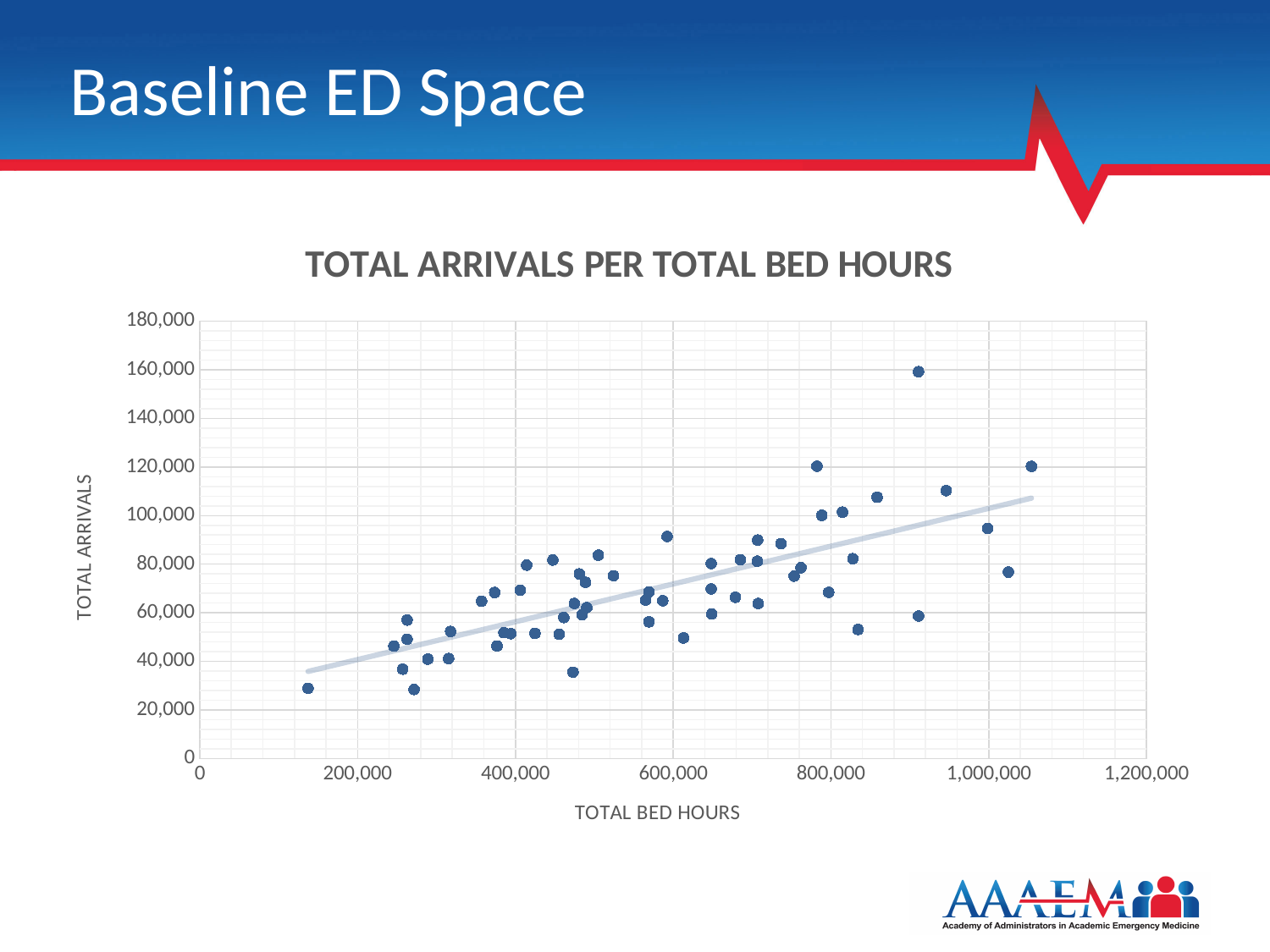
What is the highest value shown on the vertical axis of the chart? 180,000 Does the trend line on the chart slope upward or downward? Upward As total bed hours increase along the x axis, do total arrivals generally rise or fall? Rise Is the total arrivals value of the highest point on the chart greater or less than 140,000? greater Is the total arrivals value of the lowest point on the chart greater or less than 40,000? less Is the total arrivals value of the point with the highest total bed hours greater or less than 100,000? greater What is the highest value shown on the horizontal axis of the chart? 1,200,000 What kind of chart is shown on the slide? Scatter chart What is the title of the chart? TOTAL ARRIVALS PER TOTAL BED HOURS What is the label of the vertical axis of the chart? TOTAL ARRIVALS